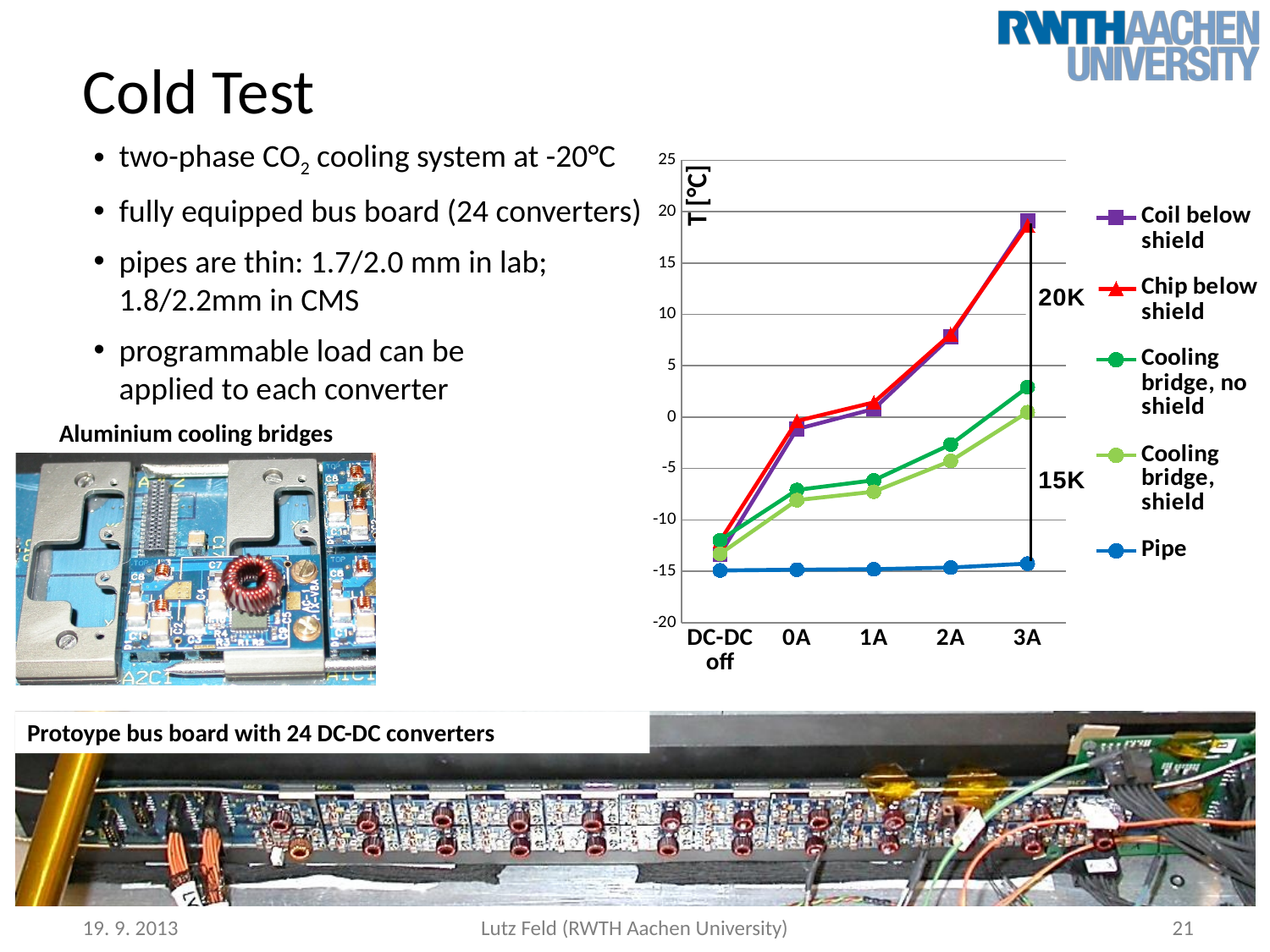
Is the value for Chip below shield at 3A greater or less than 15? greater How many categories are shown along the x axis of the chart? 5 What is the label of the y axis of the chart? T [°C] Which series is lowest at 3A? Pipe What kind of chart is shown on the slide? line chart Is the value for Pipe at 3A greater or less than -10? less At 2A, which is larger: Chip below shield or Cooling bridge, shield? Chip below shield Is the value for Coil below shield at 2A greater or less than 5? greater Does the Chip below shield series rise or fall from DC-DC off to 3A? rise How many series does the chart legend list? 5 Which series is lowest at DC-DC off? Pipe